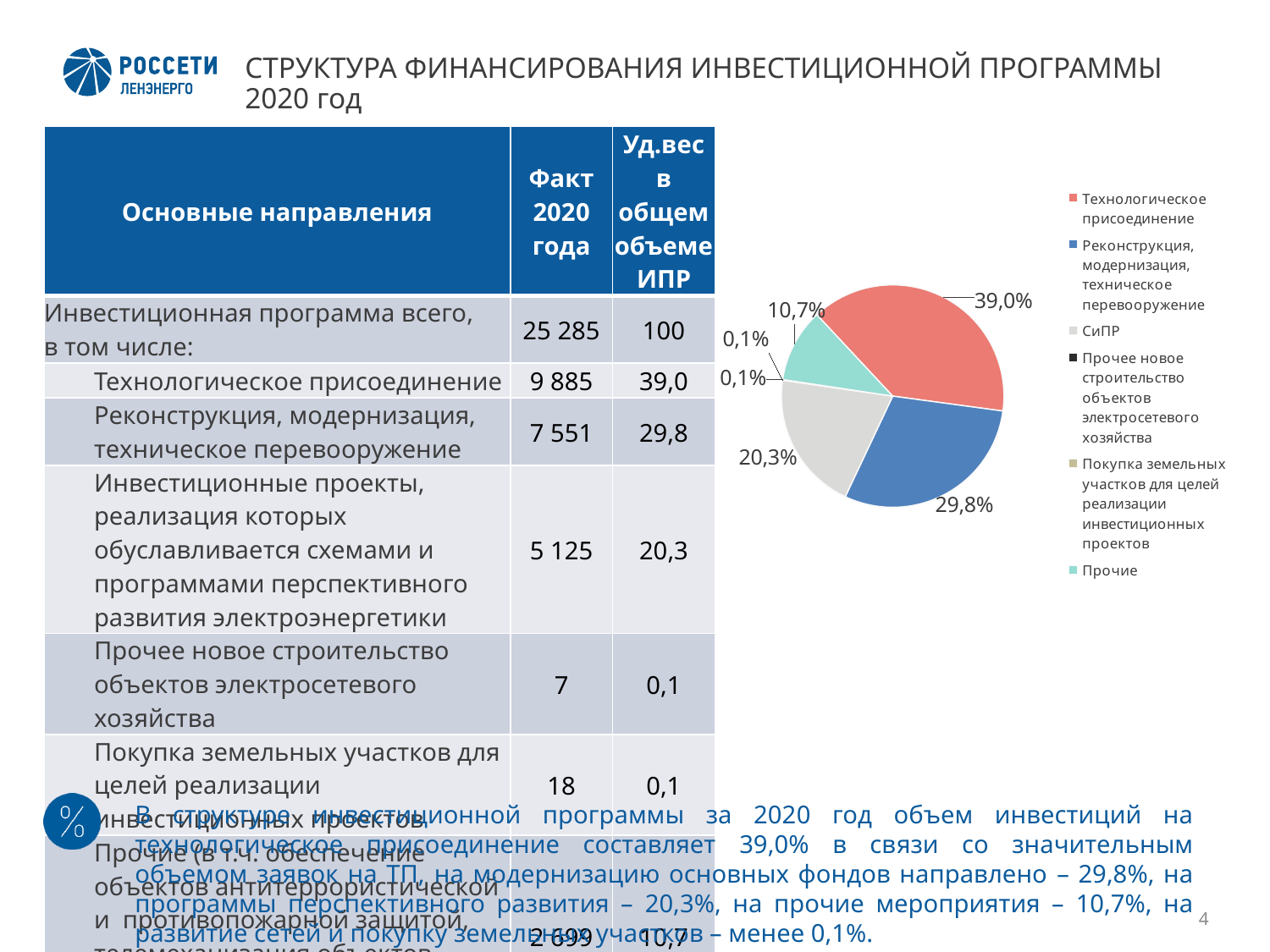
What is the difference in percentage points between the Технологическое присоединение slice and the Реконструкция, модернизация, техническое перевооружение slice? 9,2 Which is larger: the slice for СиПР or the slice for Прочие? СиПР What share of the pie does Прочее новое строительство объектов электросетевого хозяйства have? 0,1% What share of the pie does СиПР have? 20,3% What share of the pie does Прочие have? 10,7% What colour is the slice for Технологическое присоединение? red What kind of chart is shown on the slide? pie chart What share of the pie does Реконструкция, модернизация, техническое перевооружение have? 29,8% How many categories does the legend of the pie chart list? 6 Which category has the largest slice of the pie? Технологическое присоединение What share of the pie does Технологическое присоединение have? 39,0% What colour is the slice for Прочие? light green